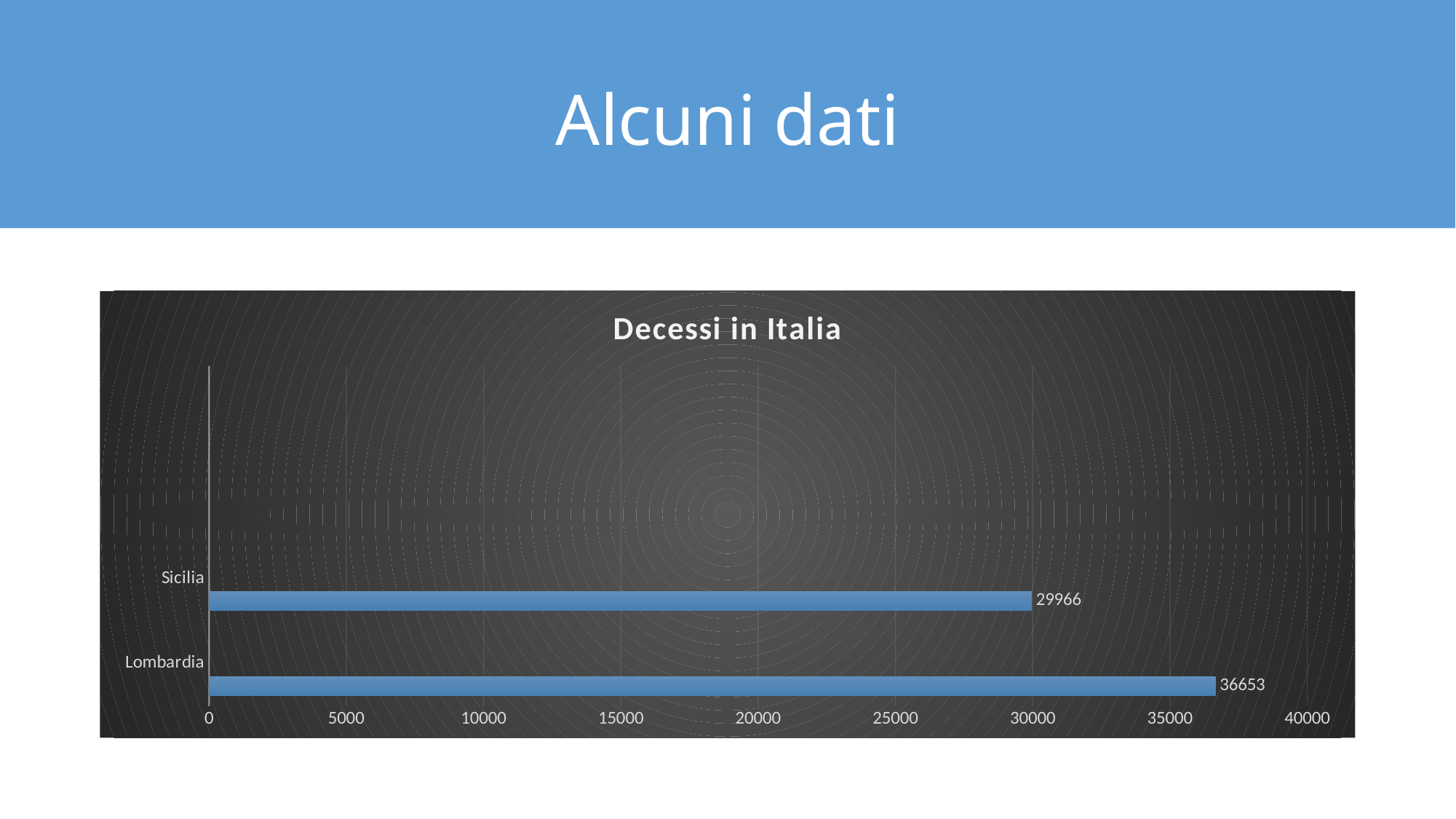
Is the value for Lombardia greater or less than 35000 in the Decessi in Italia chart? greater Which category has the lowest value in the Decessi in Italia chart? Sicilia What is the maximum value shown on the horizontal axis of the Decessi in Italia chart? 40000 What is the difference between the values for Lombardia and Sicilia in the Decessi in Italia chart? 6687 Which category has the highest value in the Decessi in Italia chart? Lombardia Which is larger in the Decessi in Italia chart, the value for Sicilia or the value for Lombardia? Lombardia What is the value for Sicilia in the Decessi in Italia chart? 29966 What is the title of the chart on the slide? Decessi in Italia Is the value for Sicilia greater or less than 30000 in the Decessi in Italia chart? less What kind of chart is shown on the slide? Bar chart What is the value for Lombardia in the Decessi in Italia chart? 36653 How many categories are shown in the Decessi in Italia chart? 2